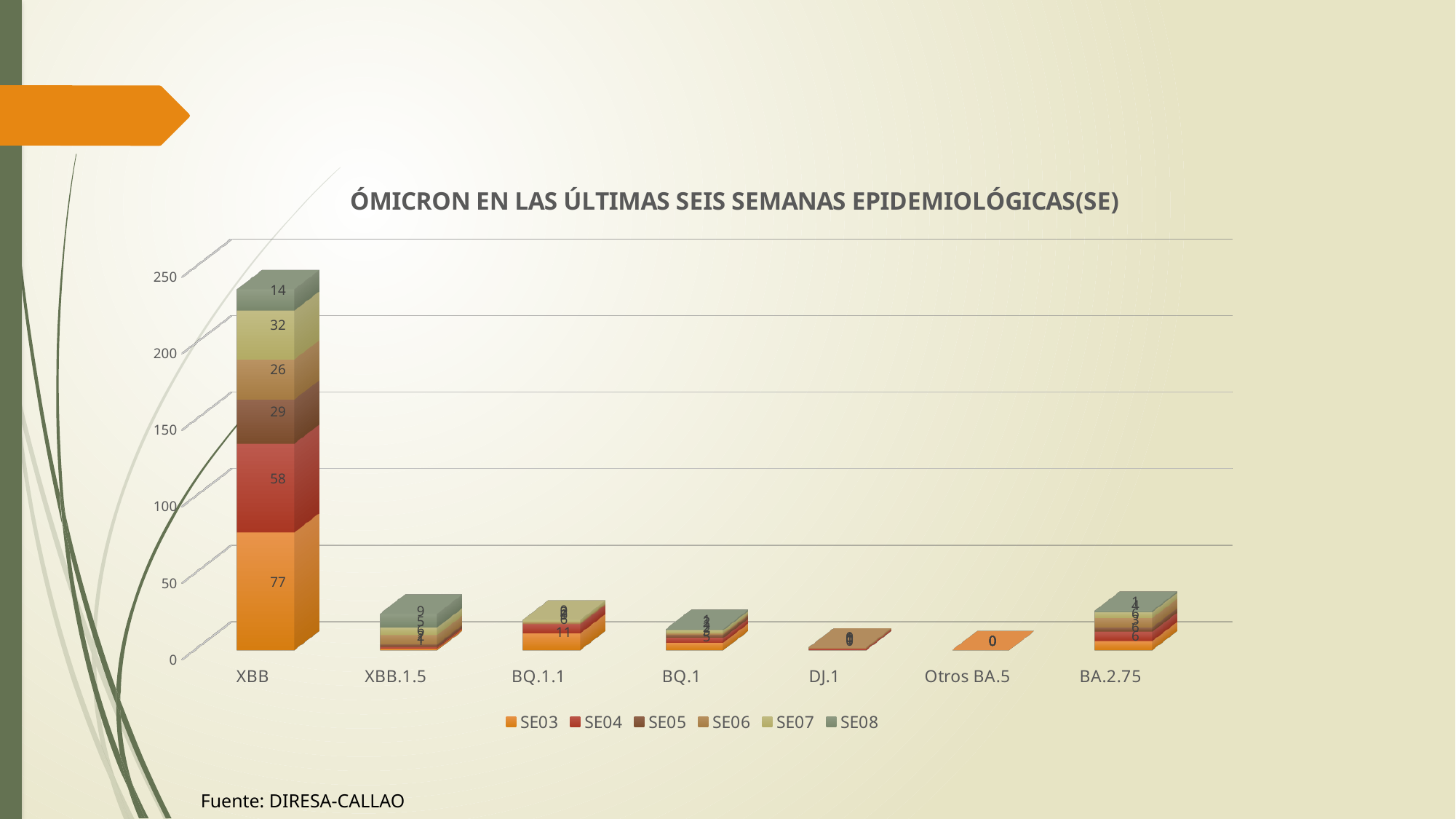
What is the SE03 value for BQ.1.1? 11 Which category has the highest total? XBB What kind of chart is shown on the slide? Stacked bar chart How many series does the legend list? 6 For XBB, which is larger: the SE06 value or the SE07 value? SE07 What is the total of the stacked bar for XBB? 236 What is the difference between the SE03 and SE04 values for XBB? 19 What is the SE03 value for XBB? 77 What is the title of the chart? ÓMICRON EN LAS ÚLTIMAS SEIS SEMANAS EPIDEMIOLÓGICAS(SE) What is the SE08 value for XBB? 14 What is the SE04 value for XBB? 58 How many categories are shown on the x axis? 7